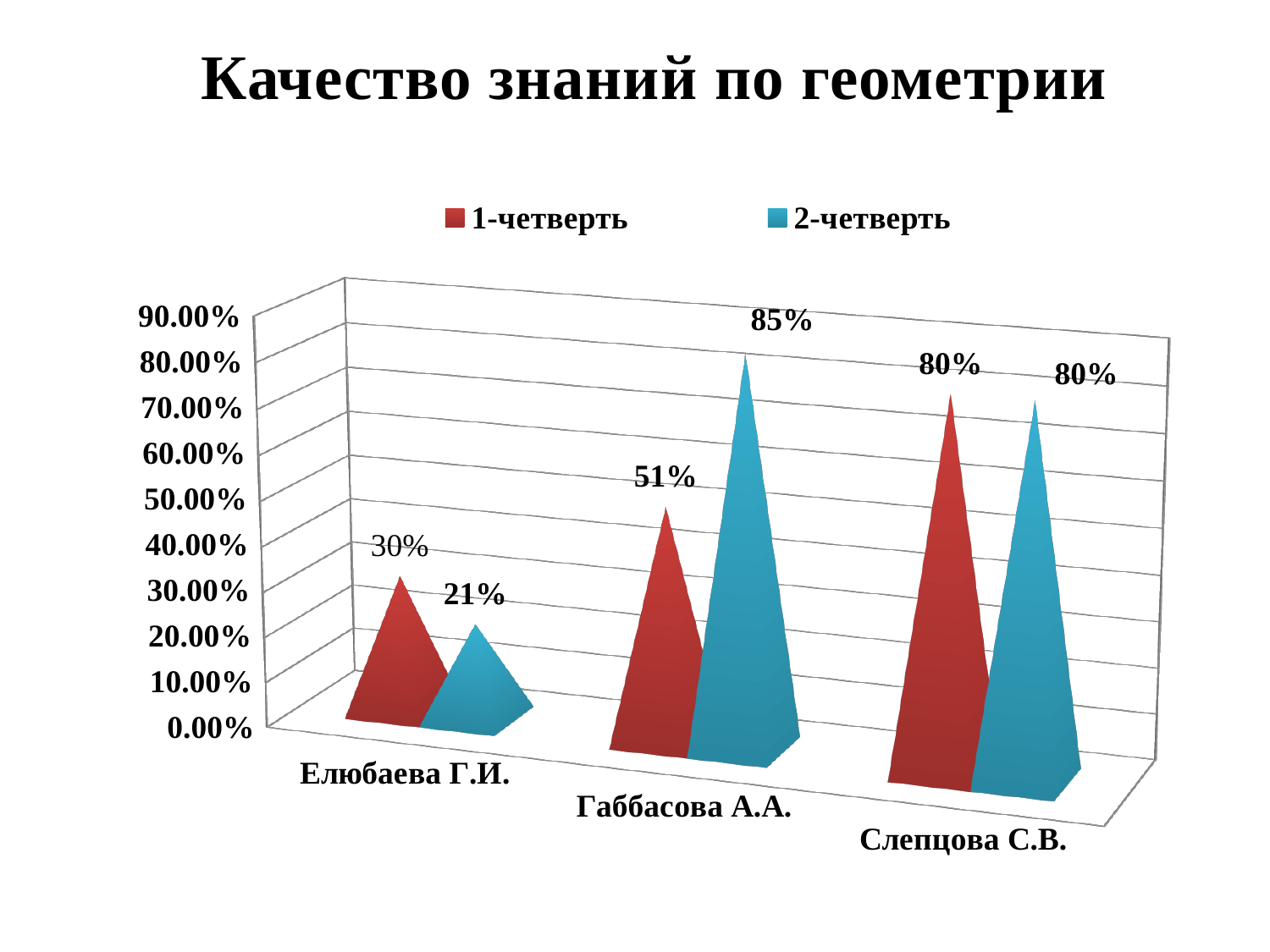
Which teacher has the highest value in the 2-четверть series? Габбасова А.А. Which teacher has the lowest value in the 1-четверть series? Елюбаева Г.И. What is the value for Слепцова С.В. in the 1-четверть series? 80% What is the difference between the 2-четверть and 1-четверть values for Габбасова А.А.? 34% What is the title of the chart? Качество знаний по геометрии What is the value for Габбасова А.А. in the 2-четверть series? 85% How many series does the legend list? 2 What is the value for Елюбаева Г.И. in the 1-четверть series? 30% What is the value for Елюбаева Г.И. in the 2-четверть series? 21% How many teachers (categories) are shown on the x axis? 3 What kind of chart is shown on the slide? Bar chart For Елюбаева Г.И., which series has the larger value, 1-четверть or 2-четверть? 1-четверть